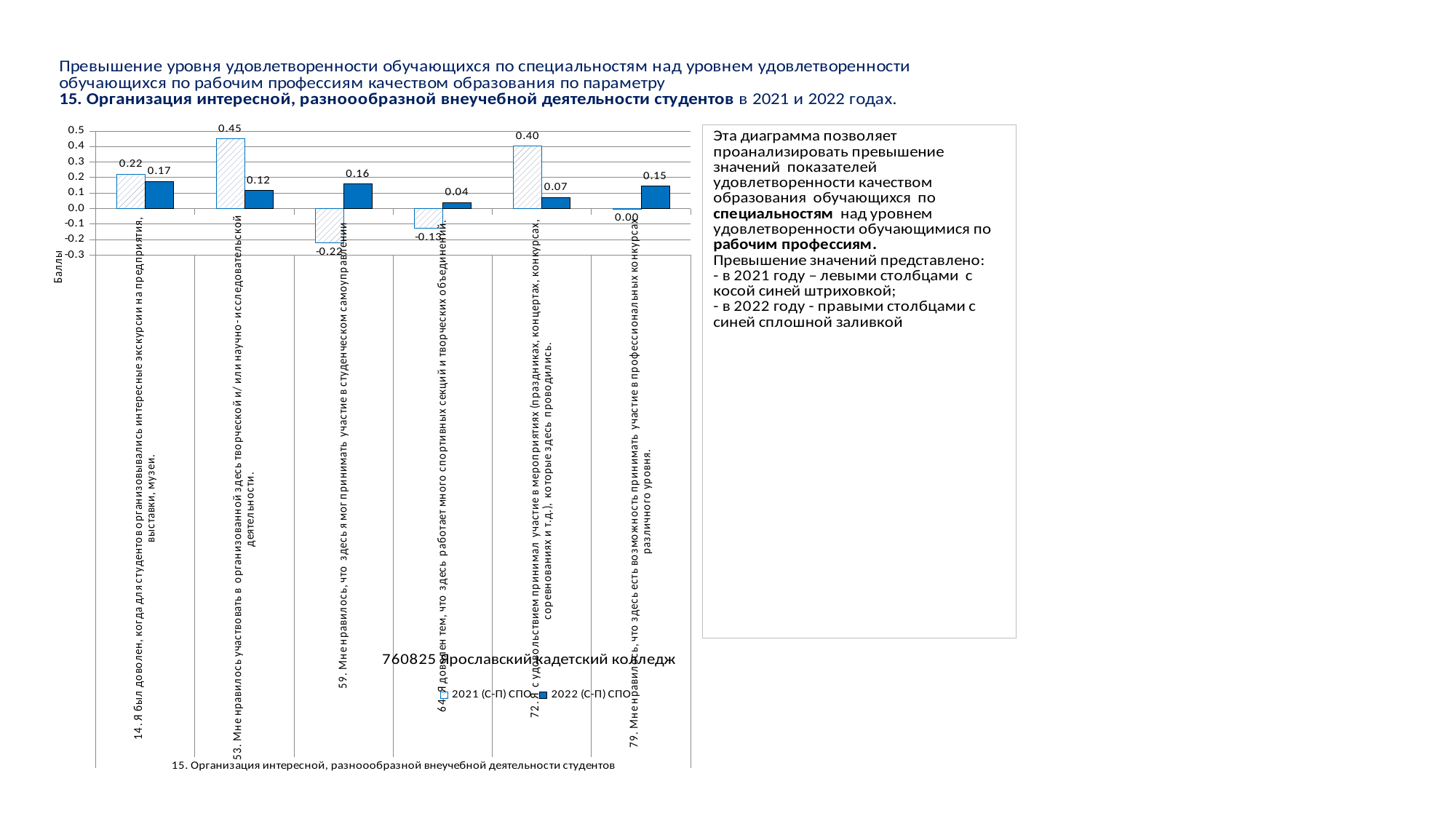
What is the 2021 (С-П) СПО value for statement 79 (Мне нравилось, что здесь есть возможность принимать участие в профессиональных конкурсах различного уровня)? 0.00 What is the 2022 (С-П) СПО value for statement 59 (Мне нравилось, что здесь я мог принимать участие в студенческом самоуправлении)? 0.16 How many series does the chart legend list? 2 For statement 14 (Я был доволен, когда для студентов организовывались интересные экскурсии), which is larger: the 2021 or the 2022 (С-П) СПО value? 2021 (С-П) СПО Which statement has the lowest 2022 (С-П) СПО value? 64. Я доволен тем, что здесь работает много спортивных секций и творческих объединений How many categories (statements) are plotted on the x axis of the chart? 6 What is the difference between the 2021 and 2022 (С-П) СПО values for statement 72 (Я с удовольствием принимал участие в мероприятиях)? 0.33 Which statement has the lowest 2021 (С-П) СПО value? 59. Мне нравилось, что здесь я мог принимать участие в студенческом самоуправлении What type of chart is shown on the slide? bar chart What is the label of the vertical axis of the chart? Баллы Which statement has the highest 2021 (С-П) СПО value? 53. Мне нравилось участвовать в организованной здесь творческой и/или научно-исследовательской деятельности What is the 2021 (С-П) СПО value for statement 53 (Мне нравилось участвовать в организованной здесь творческой и/или научно-исследовательской деятельности)? 0.45